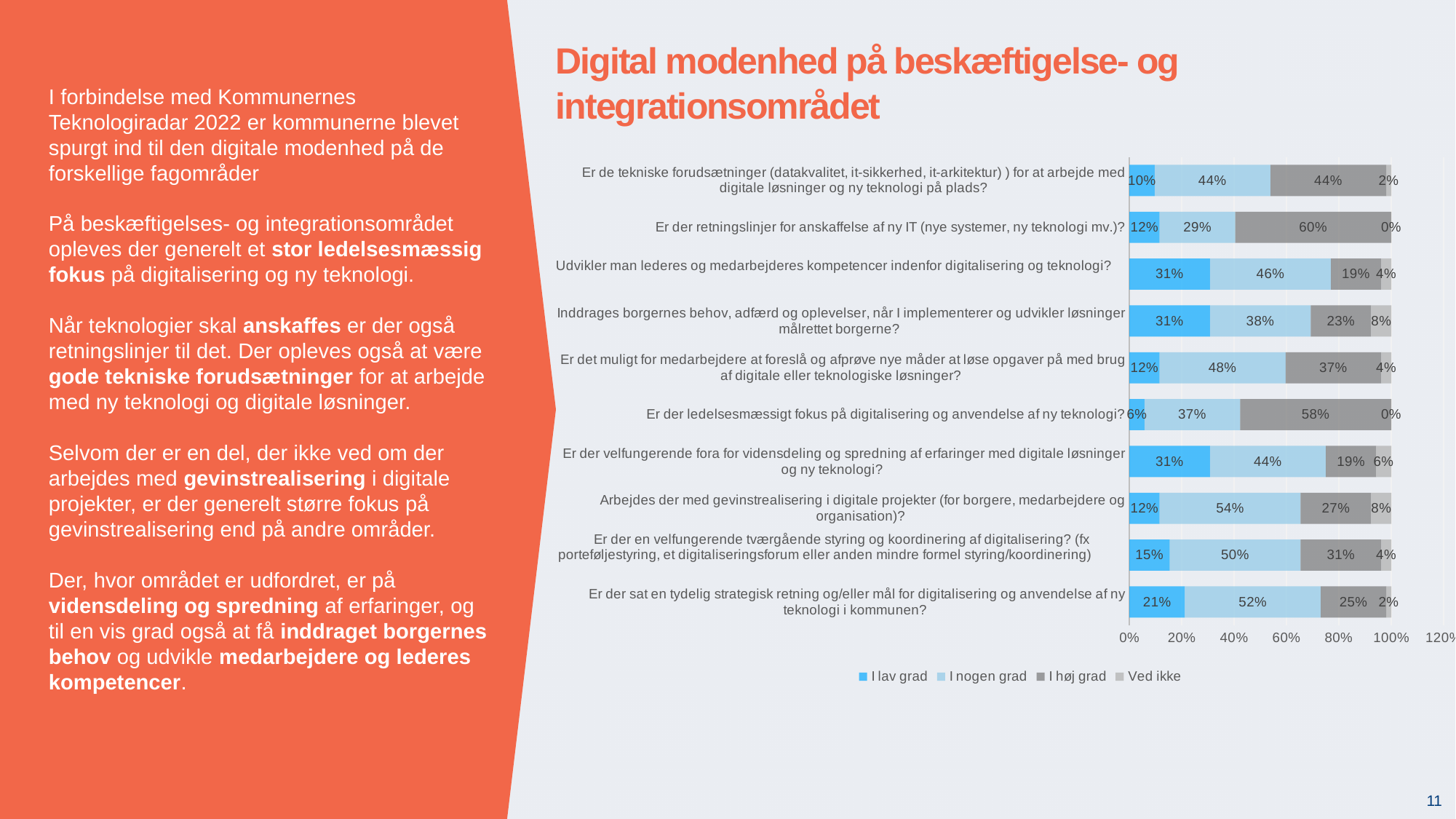
How many series does the legend list? 4 How many questions (categories) are plotted in the chart? 10 Which is larger: the 'I nogen grad' value for 'Er det muligt for medarbejdere at foreslå og afprøve nye måder at løse opgaver på...' or for 'Inddrages borgernes behov, adfærd og oplevelser...'? Er det muligt for medarbejdere at foreslå og afprøve nye måder at løse opgaver på (48%) What is the title of the chart's slide? Digital modenhed på beskæftigelse- og integrationsområdet What is the 'I lav grad' value for 'Er der ledelsesmæssigt fokus på digitalisering og anvendelse af ny teknologi?' 6% Which question has the highest 'I høj grad' share? Er der retningslinjer for anskaffelse af ny IT (nye systemer, ny teknologi mv.)? Which question has the lowest 'I lav grad' share? Er der ledelsesmæssigt fokus på digitalisering og anvendelse af ny teknologi? What is the 'I nogen grad' value for 'Arbejdes der med gevinstrealisering i digitale projekter (for borgere, medarbejdere og organisation)?' 54% What kind of chart is shown on the slide? Stacked bar chart What is the 'I høj grad' value for 'Er der retningslinjer for anskaffelse af ny IT (nye systemer, ny teknologi mv.)?' 60% What is the 'Ved ikke' value for 'Inddrages borgernes behov, adfærd og oplevelser, når I implementerer og udvikler løsninger målrettet borgerne?' 8% What is the difference between the 'I høj grad' value for 'Er der ledelsesmæssigt fokus på digitalisering og anvendelse af ny teknologi?' (58%) and for 'Er der sat en tydelig strategisk retning og/eller mål for digitalisering og anvendelse af ny teknologi i kommunen?' (25%)? 33 percentage points